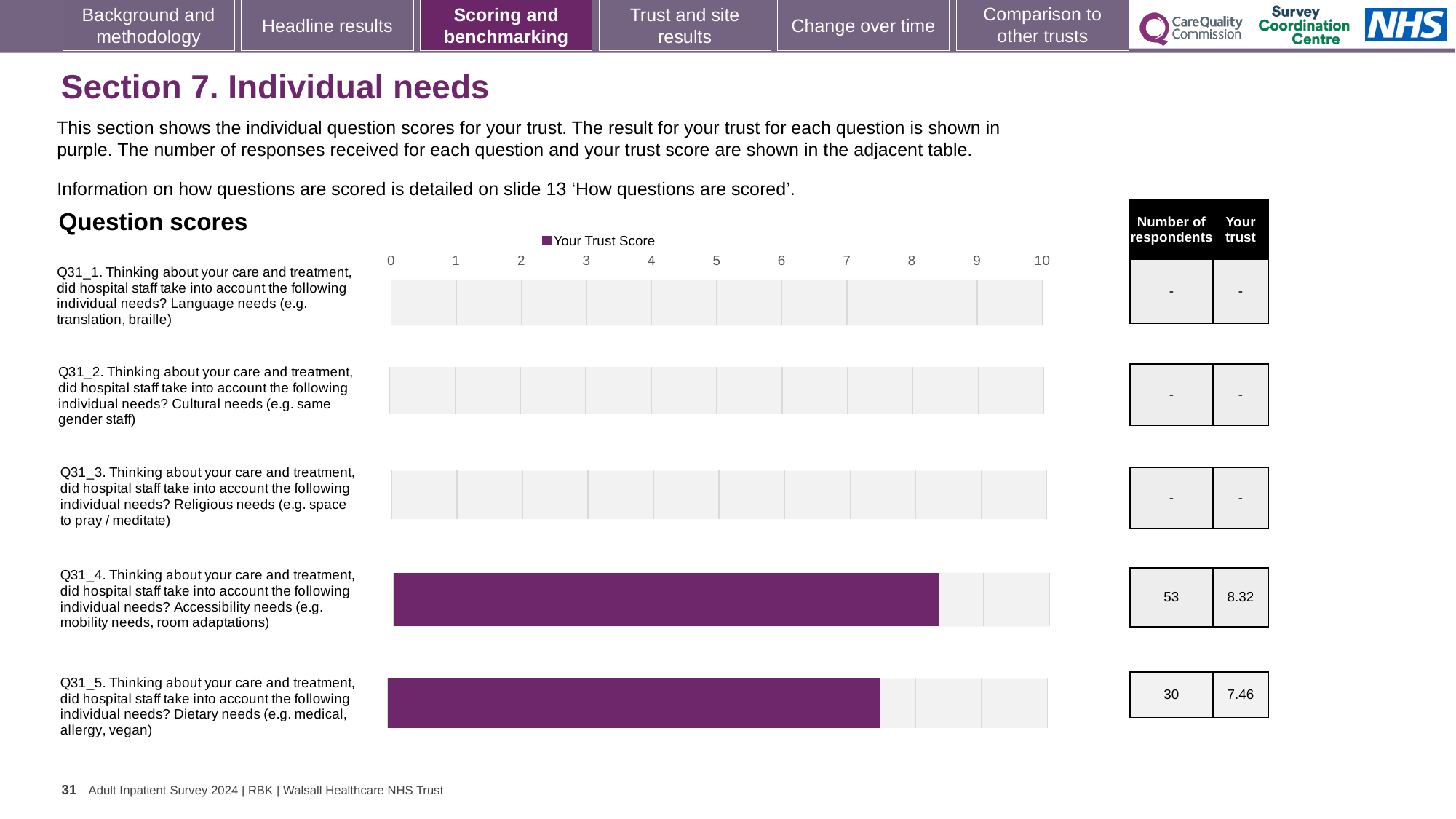
What series does the chart legend list? Your Trust Score How many questions are listed on the chart? 5 How many respondents answered Q31_4 (Accessibility needs)? 53 Is the trust score for Q31_5 (Dietary needs) greater or less than 8? less What kind of chart is shown on the slide? Bar chart Is the trust score for Q31_4 (Accessibility needs) greater or less than 8? greater How many respondents answered Q31_5 (Dietary needs)? 30 Which has the larger trust score, Q31_4 (Accessibility needs) or Q31_5 (Dietary needs)? Q31_4 (Accessibility needs) What is the difference between the trust scores for Q31_4 and Q31_5? 0.86 Which question has the highest trust score shown on the chart? Q31_4 (Accessibility needs) What is the trust score for Q31_4 (Accessibility needs)? 8.32 What is the trust score for Q31_5 (Dietary needs)? 7.46